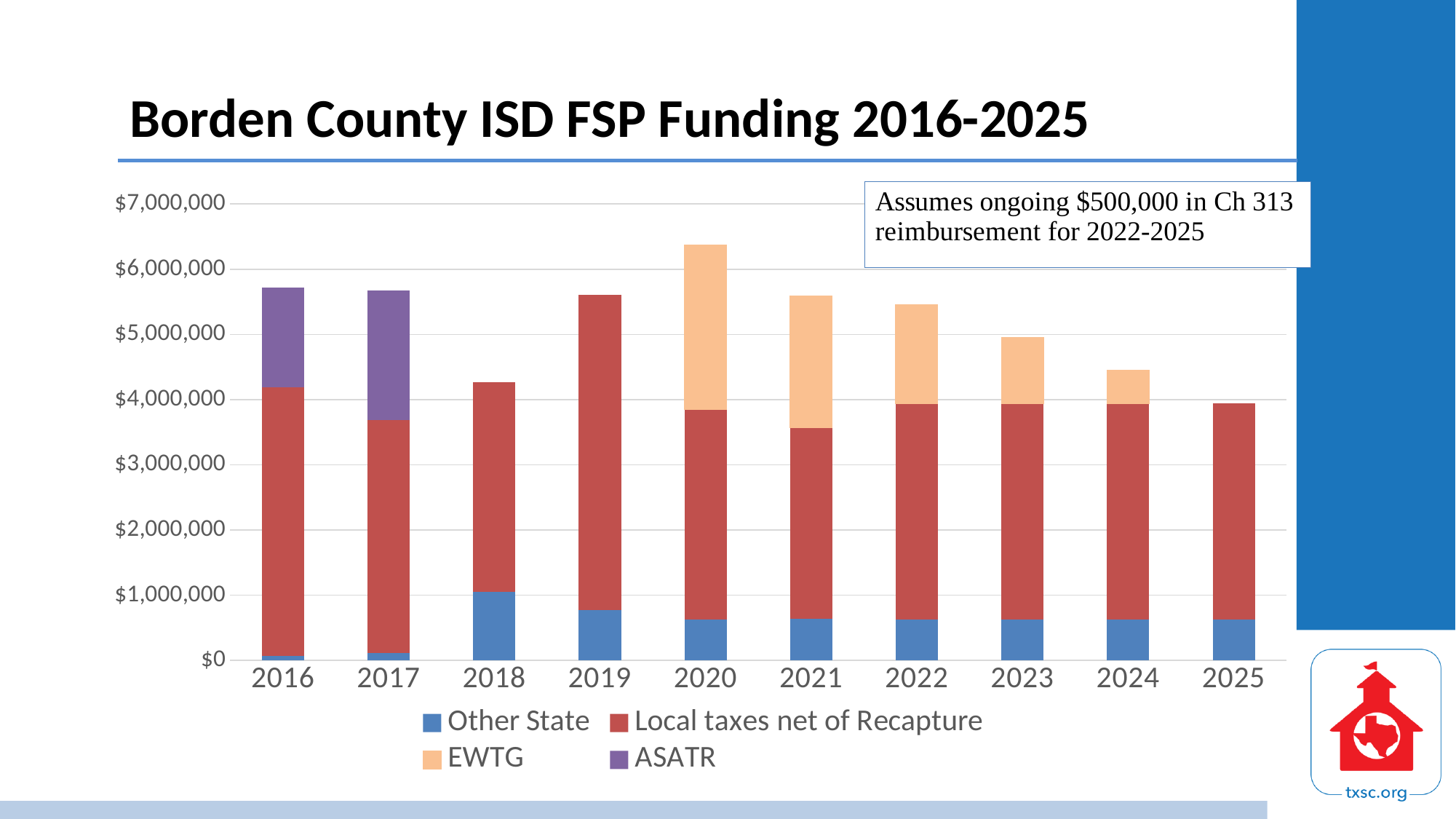
Is the total funding for 2018 greater or less than $4,000,000? greater Is the total funding for 2024 greater or less than $5,000,000? less Do the total funding values rise or fall from 2022 to 2025? fall How many series does the legend list? 4 How many years are shown on the x axis of the chart? 10 Which year has the highest total FSP funding? 2020 What kind of chart is shown on the slide? Stacked bar chart Which year has the lowest total FSP funding? 2025 Which year has the larger total funding, 2018 or 2019? 2019 In which years does the ASATR series appear in the bars? 2016 and 2017 Which series is shown in purple in the legend? ASATR Is the total funding for 2020 greater or less than $6,000,000? greater